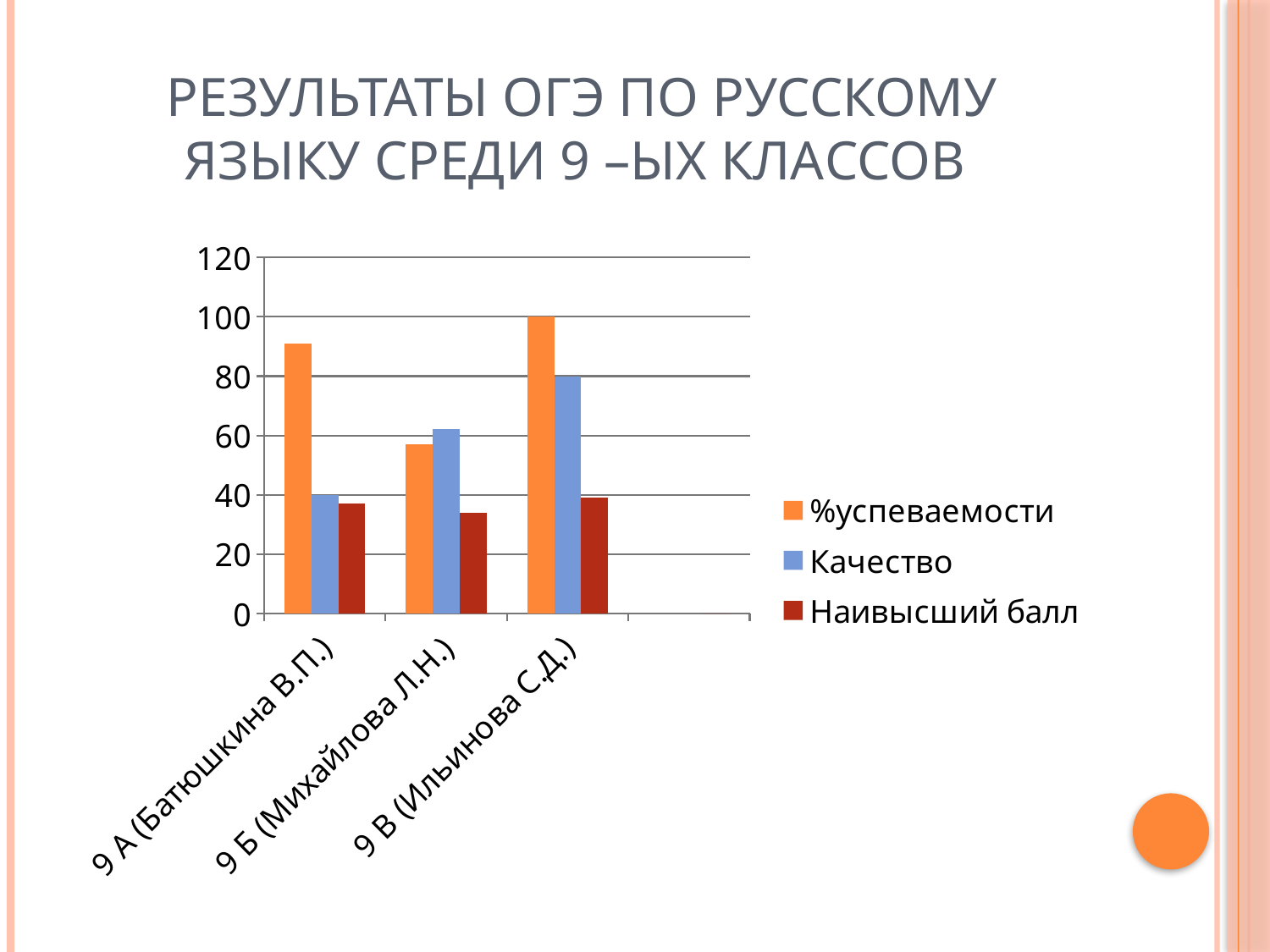
Which class has the lowest Наивысший балл? 9 Б (Михайлова Л.Н.) How many series does the legend list? 3 Which class has the highest %успеваемости? 9 В (Ильинова С.Д.) Which class has the lowest %успеваемости? 9 Б (Михайлова Л.Н.) What kind of chart is shown on the slide? bar chart Is the %успеваемости value for 9 Б (Михайлова Л.Н.) greater or less than 60? less For 9 Б (Михайлова Л.Н.), which is larger: %успеваемости or Качество? Качество What is the Качество value for 9 В (Ильинова С.Д.)? 80 What is the %успеваемости value for 9 В (Ильинова С.Д.)? 100 What is the Качество value for 9 А (Батюшкина В.П.)? 40 Is the Наивысший балл value for 9 А (Батюшкина В.П.) greater or less than 40? less How many classes (categories) are shown on the x axis? 3